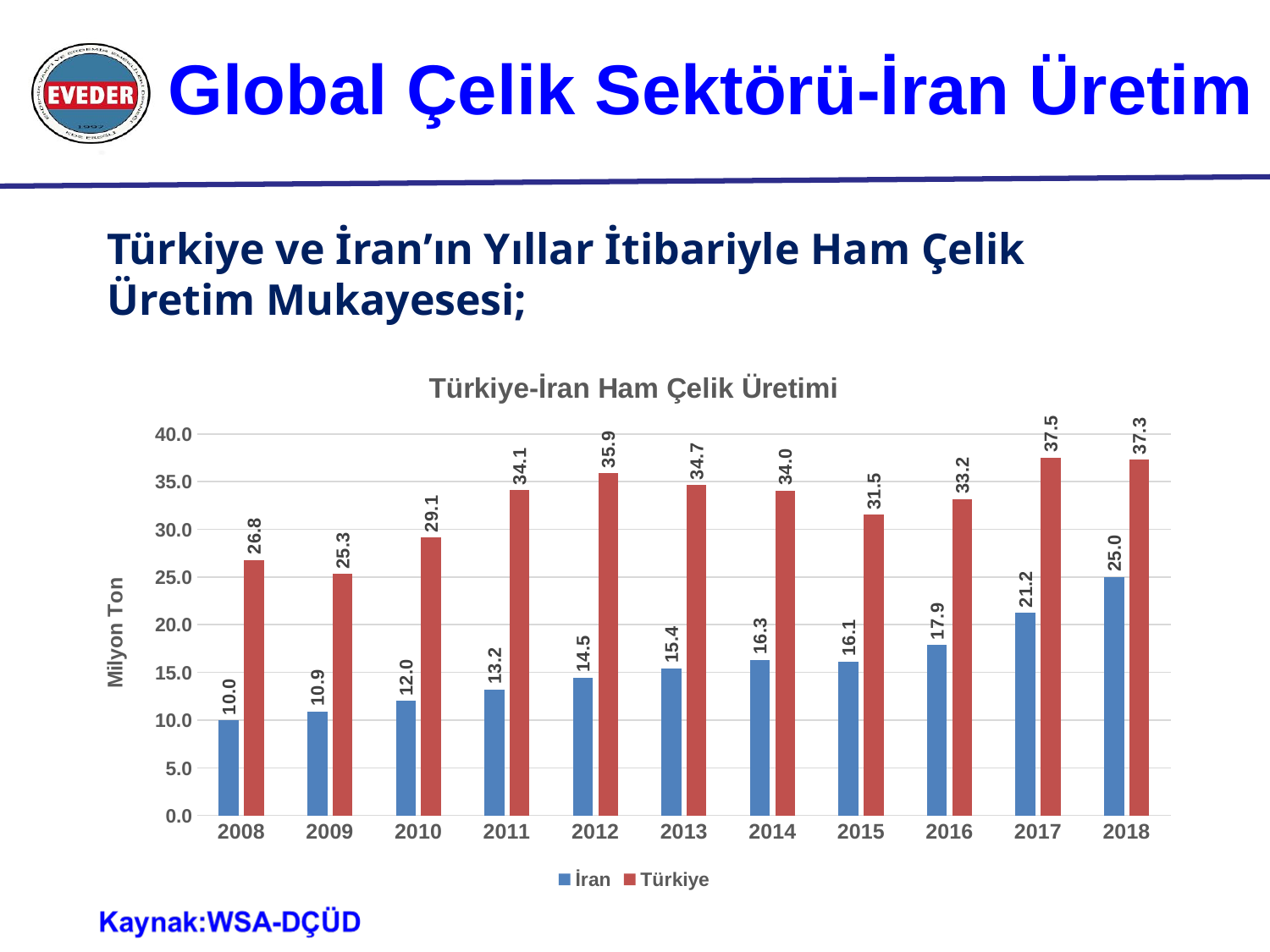
What is the value for Türkiye in 2017? 37.5 What is the value for İran in 2008? 10.0 How many series does the legend list? 2 What is the value for İran in 2018? 25.0 What kind of chart is shown? bar chart In which year is the Türkiye value lowest? 2009 Which is larger in 2016, the İran value or the Türkiye value? Türkiye What is the difference between the Türkiye and İran values in 2012? 21.4 Do the İran values rise or fall from 2008 to 2018? rise How many years are shown on the x axis? 11 Is the value for İran in 2017 greater or less than 20.0? greater In which year is the Türkiye value highest? 2017